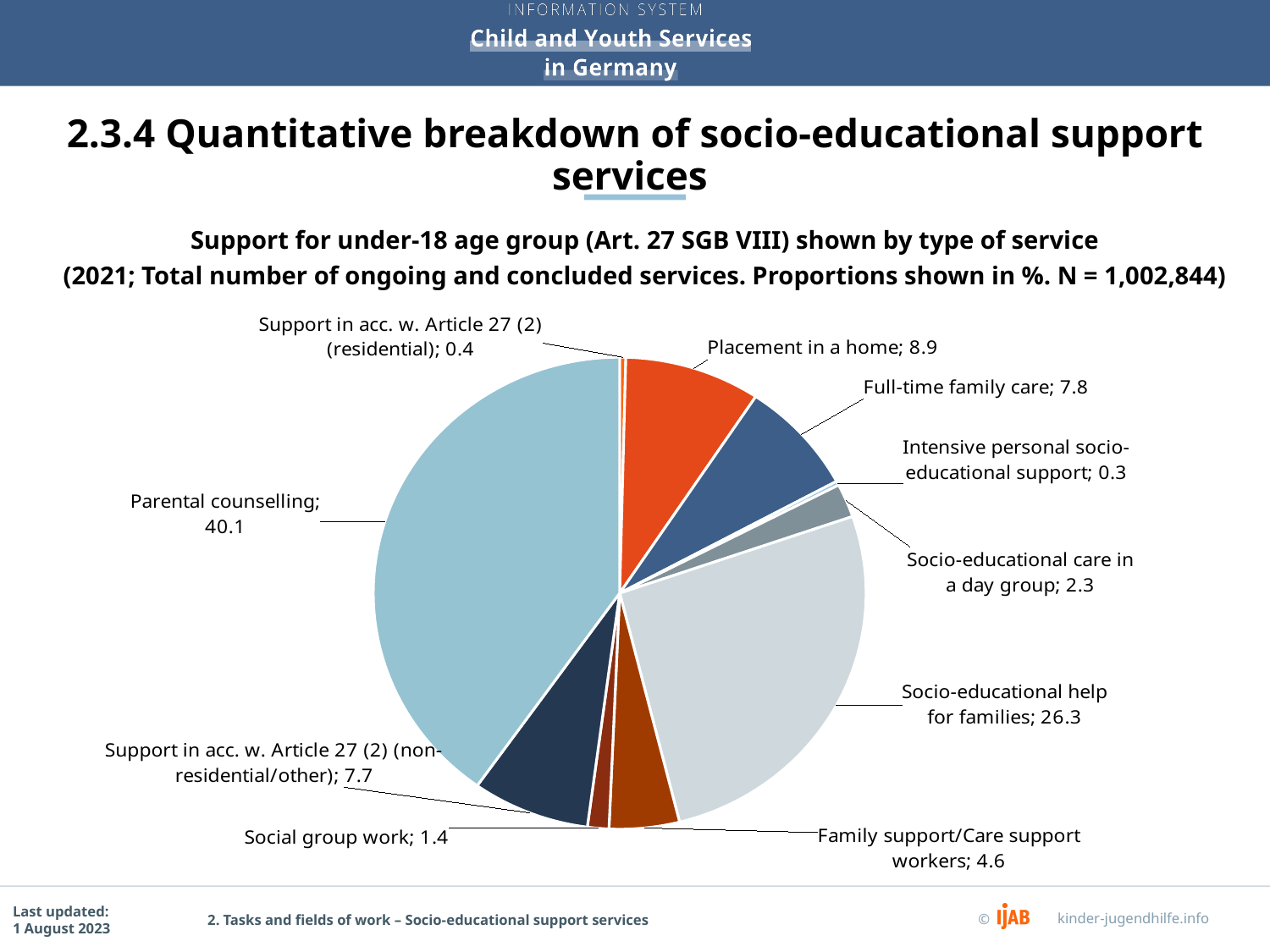
What is the value shown for Intensive personal socio-educational support? 0.3 Which type of service has the smallest share of the pie? Intensive personal socio-educational support What is the value shown for Parental counselling? 40.1 What is the value shown for Family support/Care support workers? 4.6 Which type of service has the largest share of the pie? Parental counselling What type of chart is shown on the slide? Pie chart How many types of service are shown in the pie chart? 10 What is the difference between the values for Parental counselling and Socio-educational help for families? 13.8 Which is larger, the value for Placement in a home or the value for Family support/Care support workers? Placement in a home What is the value shown for Socio-educational help for families? 26.3 What is the value shown for Placement in a home? 8.9 What is the total number N stated in the chart subtitle? 1,002,844